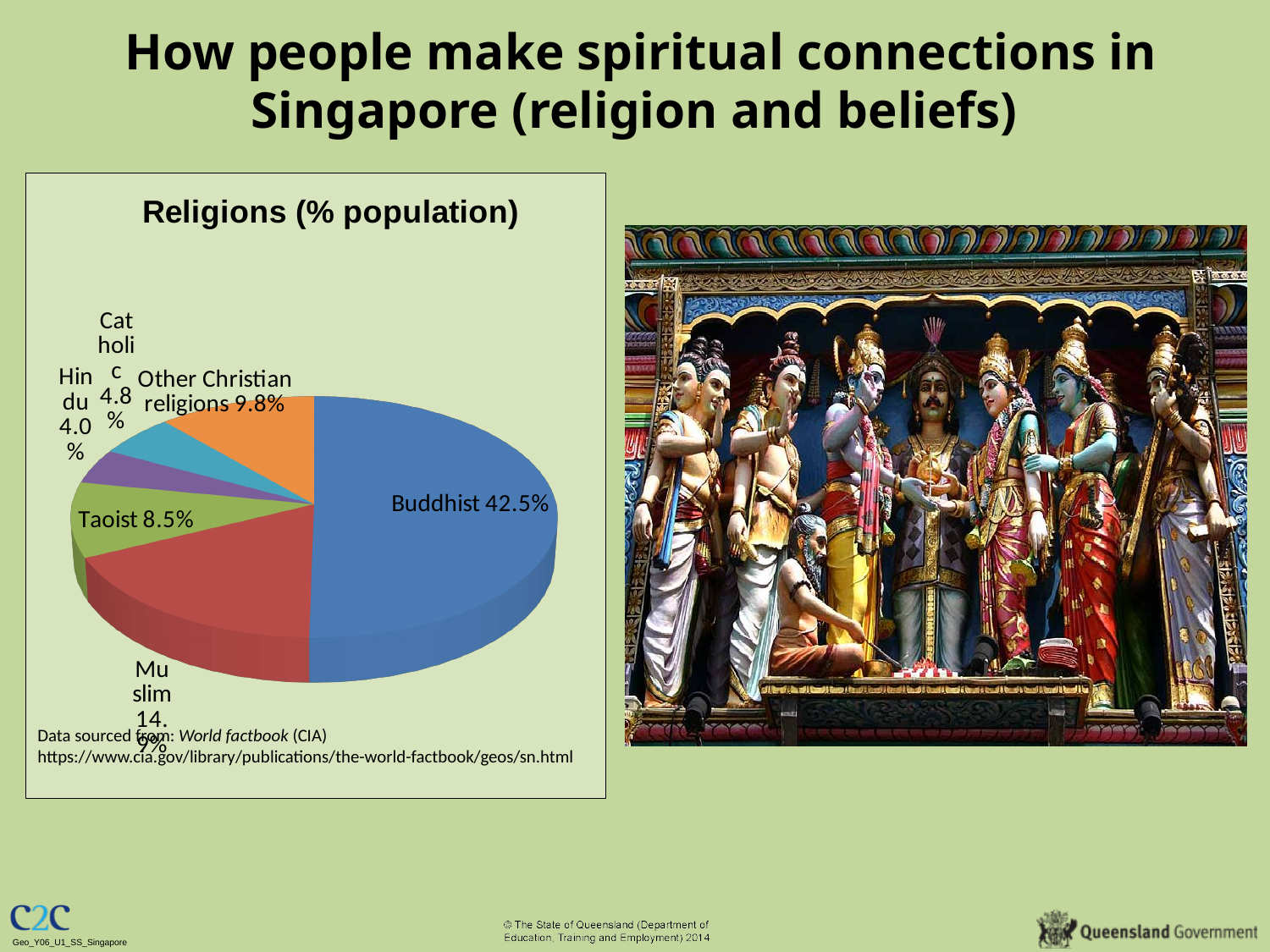
What percentage of the population is Buddhist according to the chart? 42.5% Which religion has the smallest share of the population in the chart? Hindu What is the title of the chart? Religions (% population) What percentage of the population follows Other Christian religions according to the chart? 9.8% What percentage of the population is Taoist according to the chart? 8.5% How many religion categories are shown in the pie chart? 6 Which religion has the largest share of the population in the chart? Buddhist How many percentage points larger is the Buddhist share than the Taoist share? 34.0% What percentage of the population is Muslim according to the chart? 14.9% What percentage of the population is Catholic according to the chart? 4.8% What percentage of the population is Hindu according to the chart? 4.0% What kind of chart is shown on the slide? pie chart